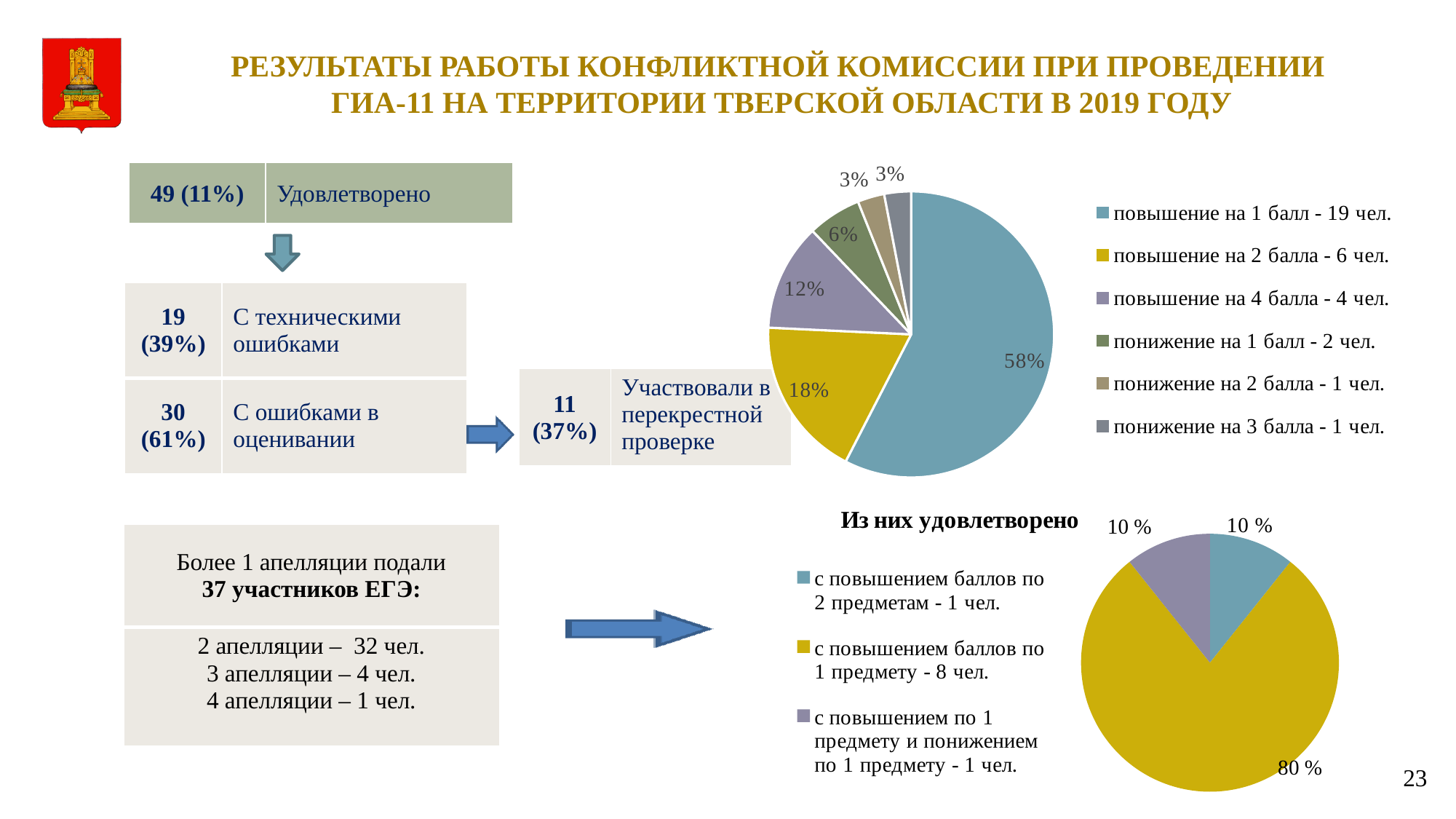
In the bottom-right pie chart 'Из них удовлетворено', which category has the largest slice? с повышением баллов по 1 предмету - 8 чел. In the top-right pie chart, which category has the largest slice? повышение на 1 балл - 19 чел. How many entries does the legend of the top-right pie chart list? 6 What is the title of the bottom-right pie chart? Из них удовлетворено What kind of chart is the top-right chart on the slide? pie chart In the top-right pie chart, what is the difference between the shares for 'повышение на 1 балл' and 'повышение на 2 балла'? 40% In the top-right pie chart, what share does the slice for 'повышение на 2 балла' have? 18% In the bottom-right pie chart 'Из них удовлетворено', what share does the slice for 'с повышением баллов по 1 предмету' have? 80 % How many slices does the bottom-right pie chart 'Из них удовлетворено' have? 3 In the top-right pie chart, what share does the slice for 'повышение на 4 балла' have? 12% In the top-right pie chart, which slice is larger: 'повышение на 4 балла' or 'понижение на 1 балл'? повышение на 4 балла